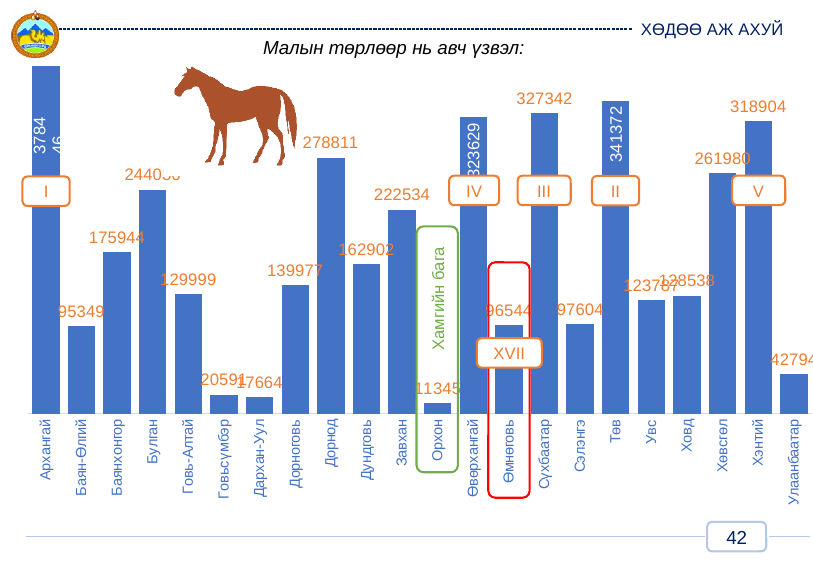
What kind of chart is shown on the slide? bar chart What is the value for Дорнод? 278811 Which category is marked with the green box labelled 'Хамгийн бага'? Орхон Which category has the lowest value? Орхон Which is larger, the value for Хэнтий or the value for Хөвсгөл? Хэнтий What is the value for Улаанбаатар? 42794 What is the difference between the values for Сүхбаатар and Өвөрхангай? 3713 What is the value for Төв? 341372 Which category has the highest value? Архангай What is the difference between the values for Дорнод and Завхан? 56277 What is the value for Орхон? 11345 How many categories are shown on the x axis? 22